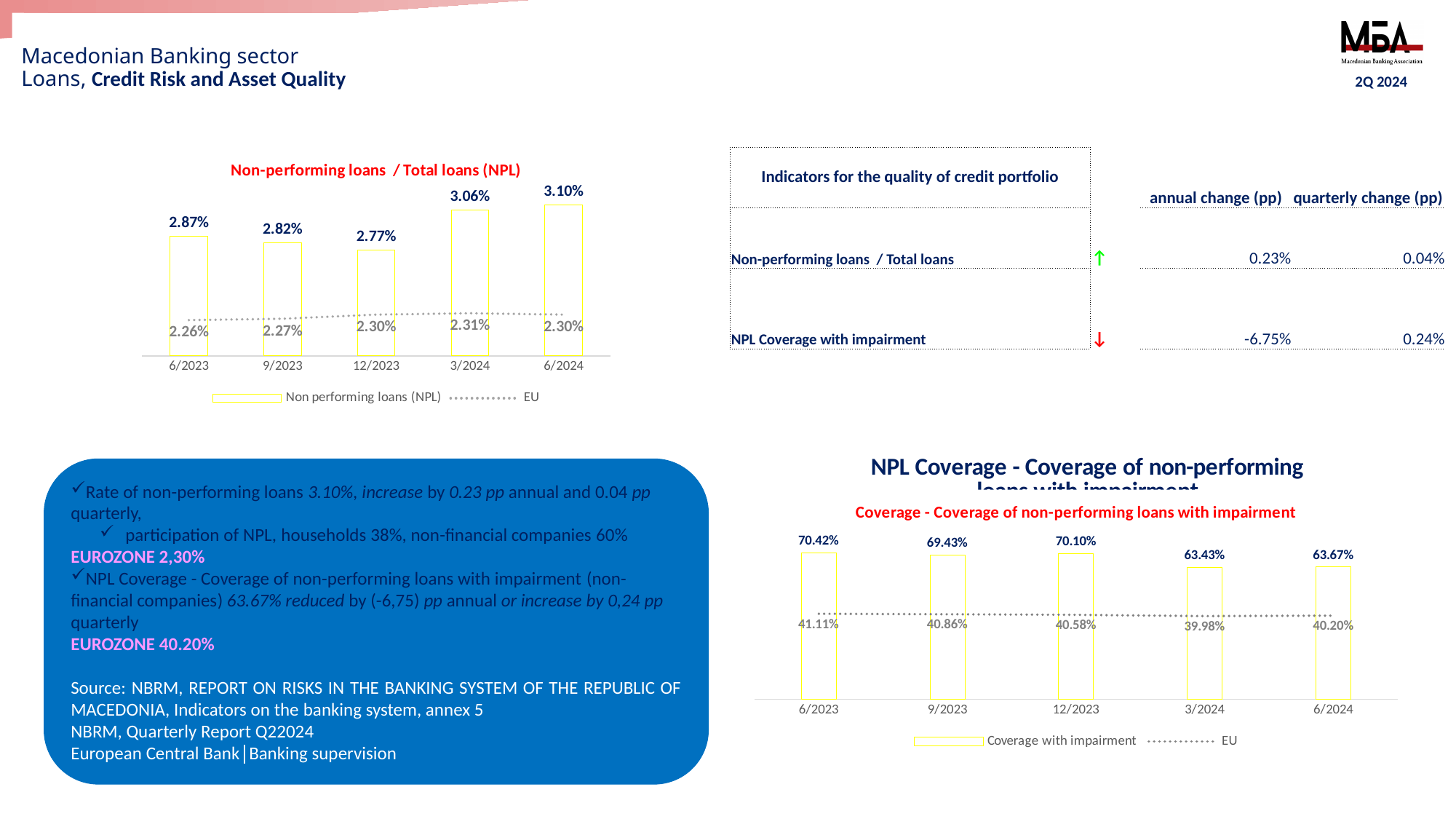
In the 'Coverage - Coverage of non-performing loans with impairment' chart, which period has the highest coverage with impairment bar? 6/2023 In the 'Coverage - Coverage of non-performing loans with impairment' chart, what is the difference between the coverage with impairment value for 6/2023 and for 6/2024? 6.75% In the 'Coverage - Coverage of non-performing loans with impairment' chart, what is the coverage with impairment value for 3/2024? 63.43% What kind of chart is the 'Coverage - Coverage of non-performing loans with impairment' chart? Bar chart with a dotted line In the 'Coverage - Coverage of non-performing loans with impairment' chart, is the coverage with impairment value for 9/2023 or for 12/2023 larger? 12/2023 In the 'Non-performing loans / Total loans (NPL)' chart, how many series does the legend list? 2 In the 'Non-performing loans / Total loans (NPL)' chart, what is the difference between the NPL value for 6/2024 and the NPL value for 6/2023? 0.23% In the 'Non-performing loans / Total loans (NPL)' chart, what is the NPL value for 6/2024? 3.10% In the 'Non-performing loans / Total loans (NPL)' chart, what is the EU value for 12/2023? 2.30% In the 'Non-performing loans / Total loans (NPL)' chart, how many periods are shown on the x axis? 5 In the 'Coverage - Coverage of non-performing loans with impairment' chart, what is the EU value for 6/2024? 40.20% In the 'Non-performing loans / Total loans (NPL)' chart, which period has the lowest NPL bar? 12/2023